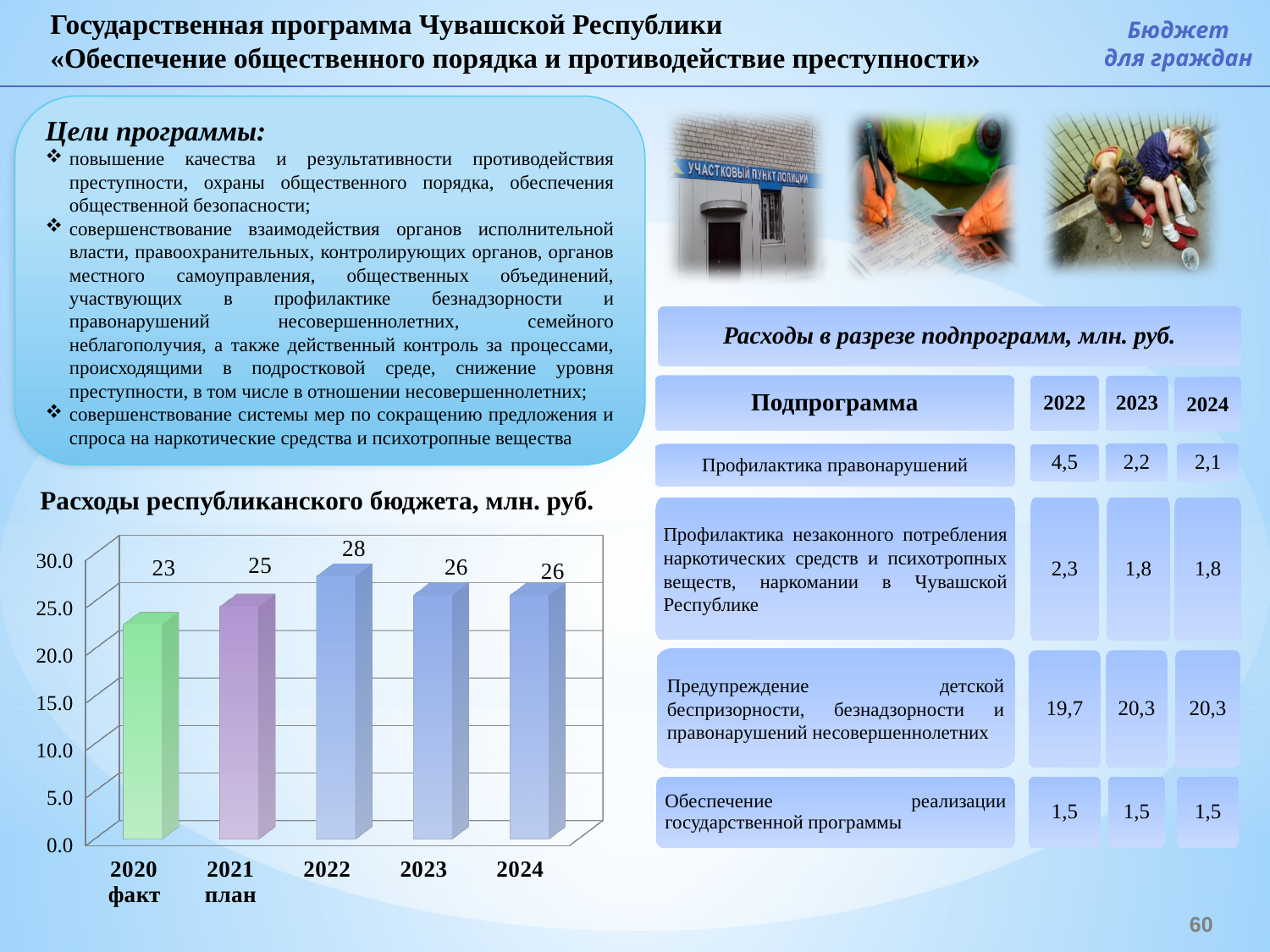
What is the value for 2024 in the chart 'Расходы республиканского бюджета, млн. руб.'? 26 Is the value for 2020 факт greater or less than 25.0 in the chart 'Расходы республиканского бюджета, млн. руб.'? less How many bars are shown in the chart 'Расходы республиканского бюджета, млн. руб.'? 5 Which year has the highest value in the chart 'Расходы республиканского бюджета, млн. руб.'? 2022 Which year has the lowest value in the chart 'Расходы республиканского бюджета, млн. руб.'? 2020 факт What is the value for 2020 факт in the chart 'Расходы республиканского бюджета, млн. руб.'? 23 What is the difference between the values for 2022 and 2020 факт in the chart 'Расходы республиканского бюджета, млн. руб.'? 5 What is the difference between the values for 2021 план and 2023 in the chart 'Расходы республиканского бюджета, млн. руб.'? 1 What is the title of the chart on the left side of the slide? Расходы республиканского бюджета, млн. руб. What kind of chart is 'Расходы республиканского бюджета, млн. руб.'? bar chart What is the value for 2022 in the chart 'Расходы республиканского бюджета, млн. руб.'? 28 Which is larger in the chart 'Расходы республиканского бюджета, млн. руб.': the value for 2021 план or the value for 2022? 2022